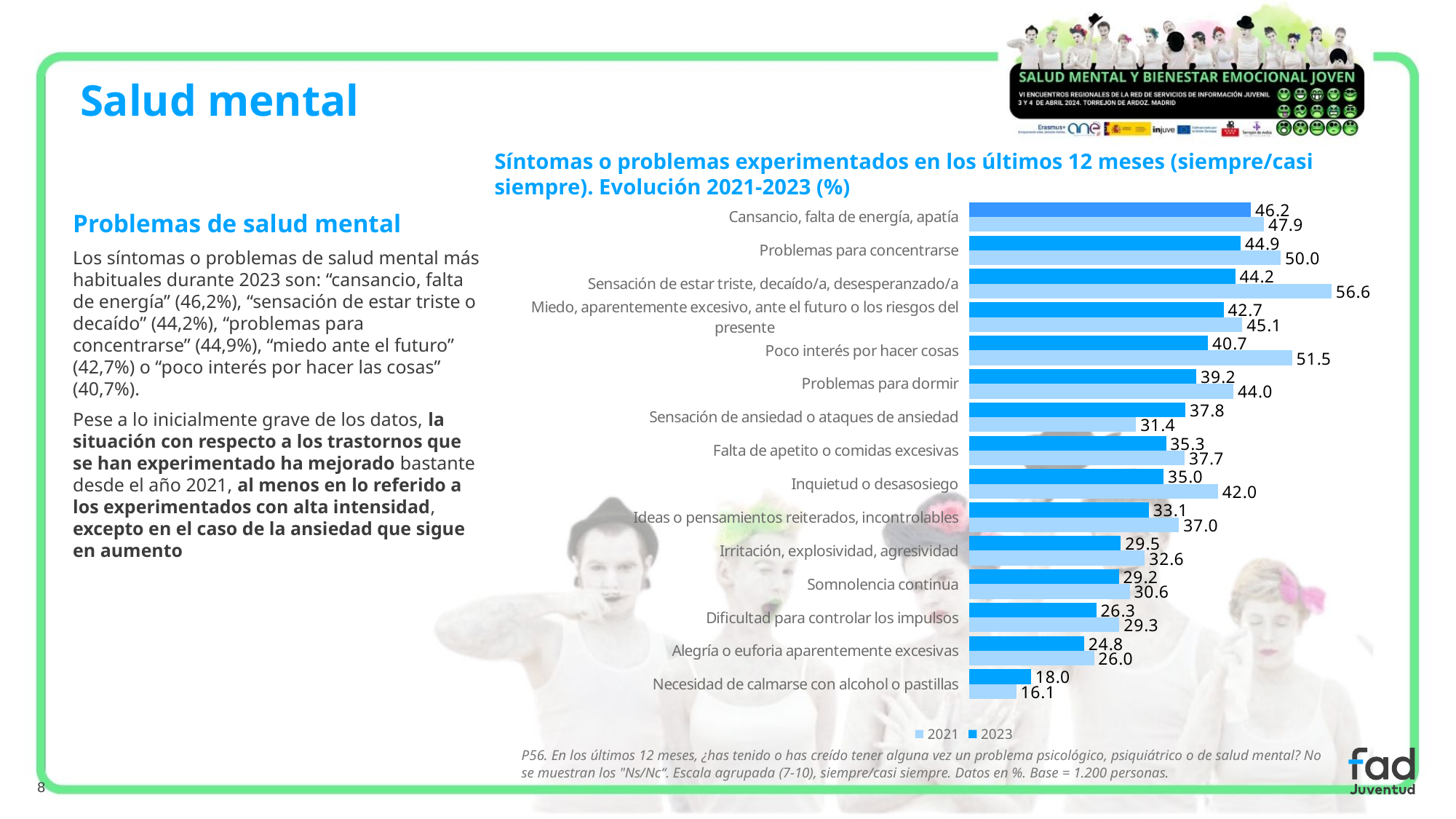
What is the difference between the 2021 and 2023 values for "Problemas para concentrarse"? 5.1 Which category has the lowest 2023 value? Necesidad de calmarse con alcohol o pastillas How many categories are shown in the chart? 15 What is the 2023 value for "Cansancio, falta de energía, apatía"? 46.2 How many series does the legend list? 2 What is the 2023 value for "Necesidad de calmarse con alcohol o pastillas"? 18.0 What is the 2021 value for "Sensación de estar triste, decaído/a, desesperanzado/a"? 56.6 What is the difference between the 2021 and 2023 values for "Poco interés por hacer cosas"? 10.8 Which category has the highest 2021 value? Sensación de estar triste, decaído/a, desesperanzado/a What type of chart is shown on the slide? Bar chart For "Sensación de ansiedad o ataques de ansiedad", which year has the larger value, 2021 or 2023? 2023 Which years are listed in the chart legend? 2021 and 2023